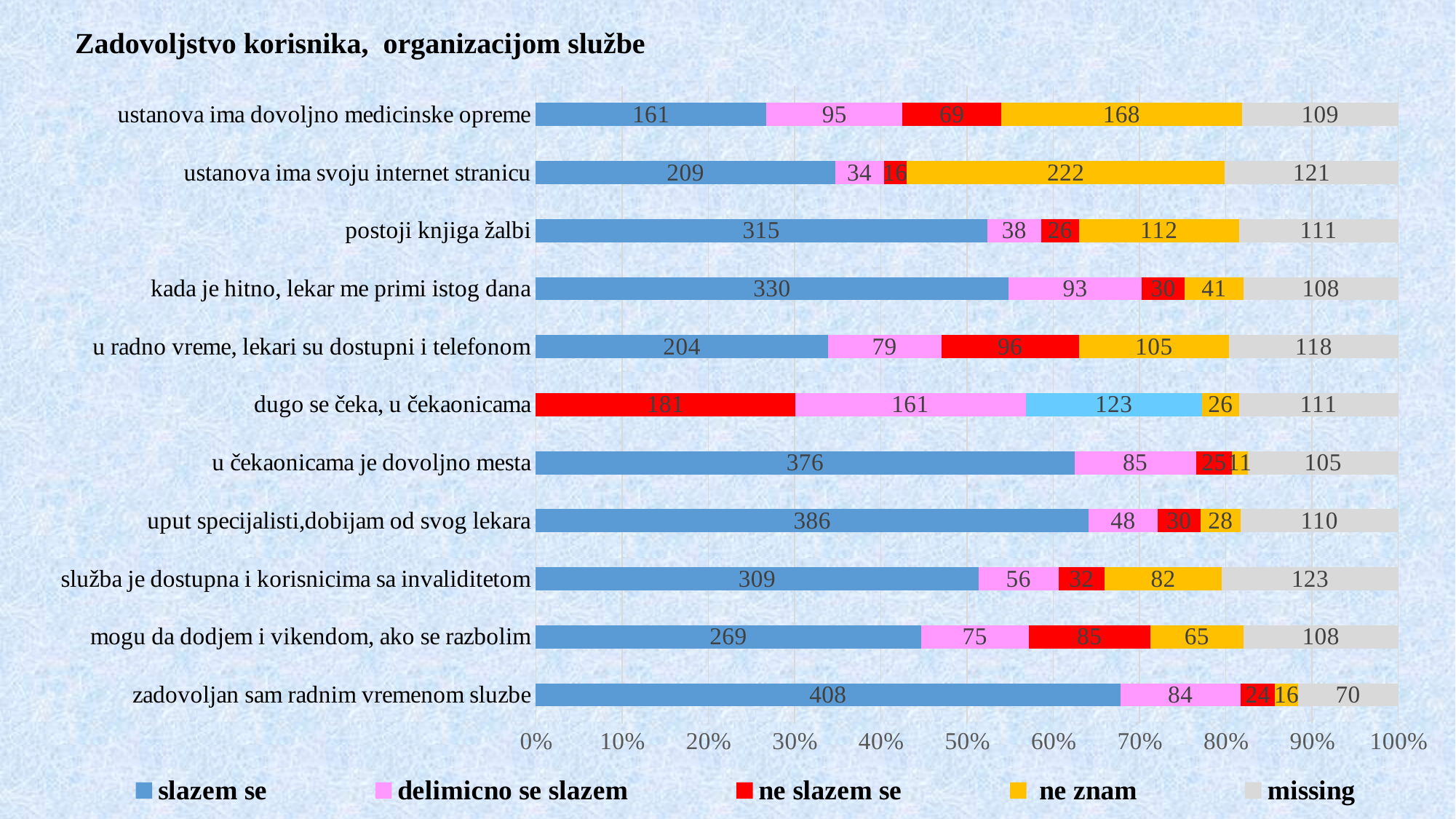
Which has a larger "ne znam" value: "ustanova ima dovoljno medicinske opreme" or "postoji knjiga žalbi"? ustanova ima dovoljno medicinske opreme How many series does the legend list? 5 What is the total of all segments in the bar for "ustanova ima dovoljno medicinske opreme"? 602 What is the difference between the "ne slazem se" values for "u radno vreme, lekari su dostupni i telefonom" and "kada je hitno, lekar me primi istog dana"? 66 What is the value of "slazem se" for "zadovoljan sam radnim vremenom sluzbe"? 408 What is the value of "delimicno se slazem" for "kada je hitno, lekar me primi istog dana"? 93 What kind of chart is shown on the slide? Stacked bar chart Which category has the lowest "missing" value? zadovoljan sam radnim vremenom sluzbe What is the "missing" value for "služba je dostupna i korisnicima sa invaliditetom"? 123 Which category has the highest "slazem se" value? zadovoljan sam radnim vremenom sluzbe How many categories (statements) are shown in the chart? 11 What is the value of "ne znam" for "ustanova ima svoju internet stranicu"? 222